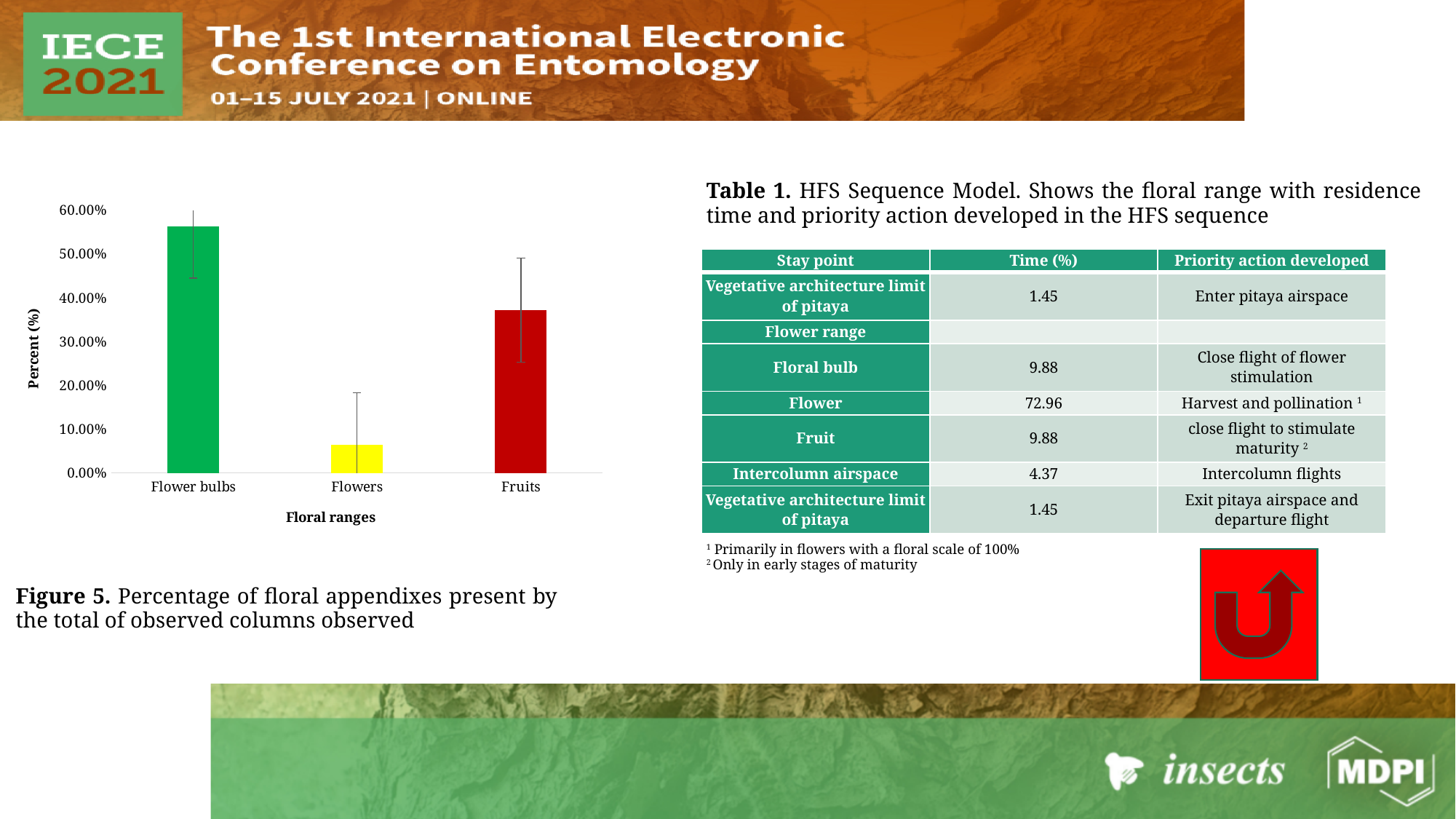
Is the value for Flowers greater or less than 10.00%? less Which has a higher percentage in the bar chart, Flower bulbs or Fruits? Flower bulbs What kind of chart is shown in Figure 5? bar chart How many floral range categories are plotted in the bar chart? 3 Which floral range has the highest percentage in the bar chart? Flower bulbs What is the label of the x axis in the bar chart? Floral ranges Which floral range has the lowest percentage in the bar chart? Flowers Which has a higher percentage in the bar chart, Fruits or Flowers? Fruits What is the label of the y axis in the bar chart? Percent (%) Is the value for Fruits greater or less than 30.00%? greater Is the value for Flower bulbs greater or less than 50.00%? greater